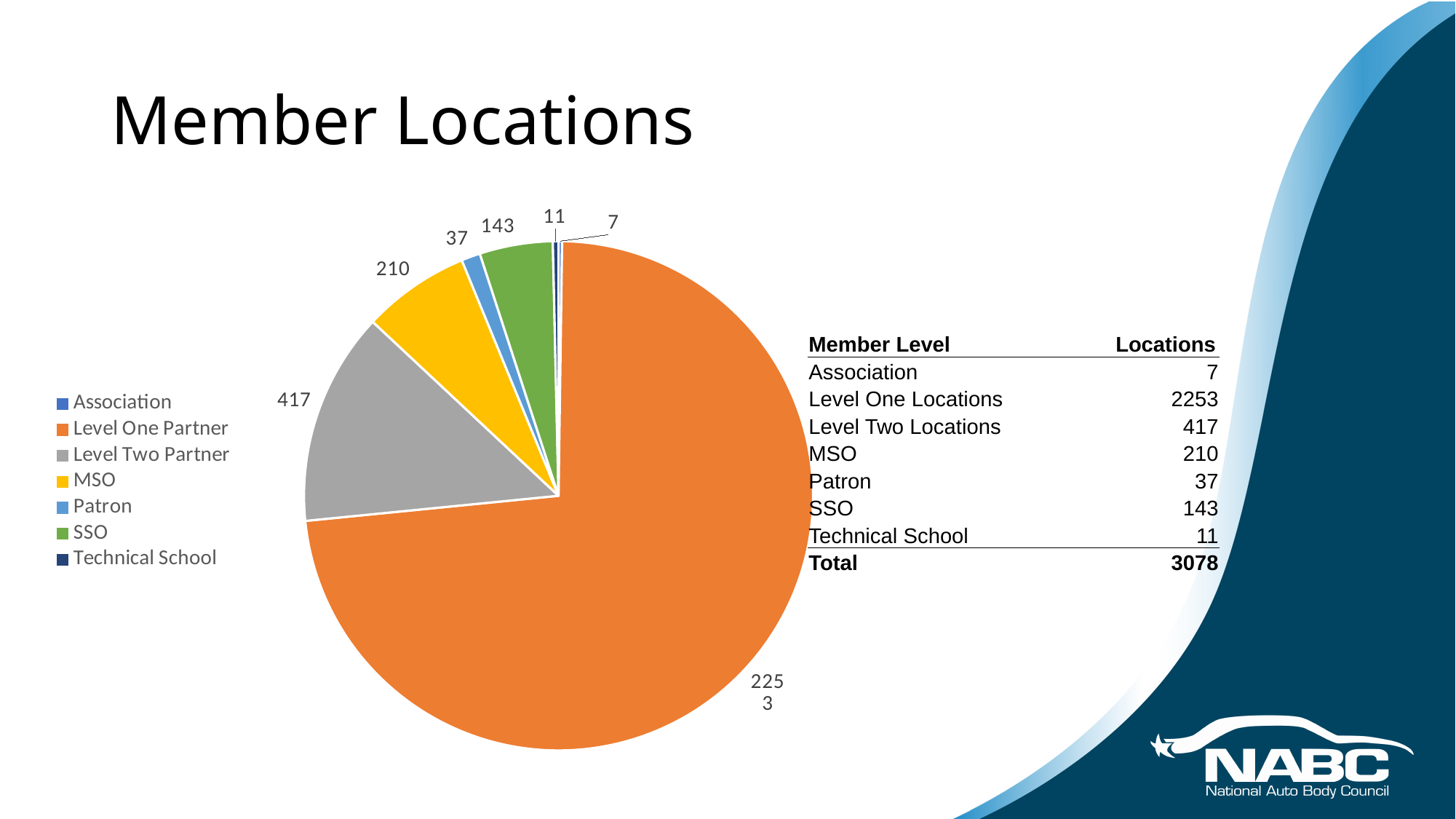
What is the difference between the values for Level Two Partner and MSO? 207 How many categories does the pie chart have? 7 What is the value for SSO in the pie chart? 143 Which category has the smallest slice in the pie chart? Association What kind of chart is shown on the slide? pie chart What colour is the Level Two Partner slice in the pie chart? grey What is the value for Patron in the pie chart? 37 What is the value for Level Two Partner in the pie chart? 417 What share of the pie does Level One Partner represent, given the total of 3078? 73.2% Which category has the largest slice in the pie chart? Level One Partner Which is larger, the value for SSO or the value for MSO? MSO What is the value for Level One Partner in the pie chart? 2253